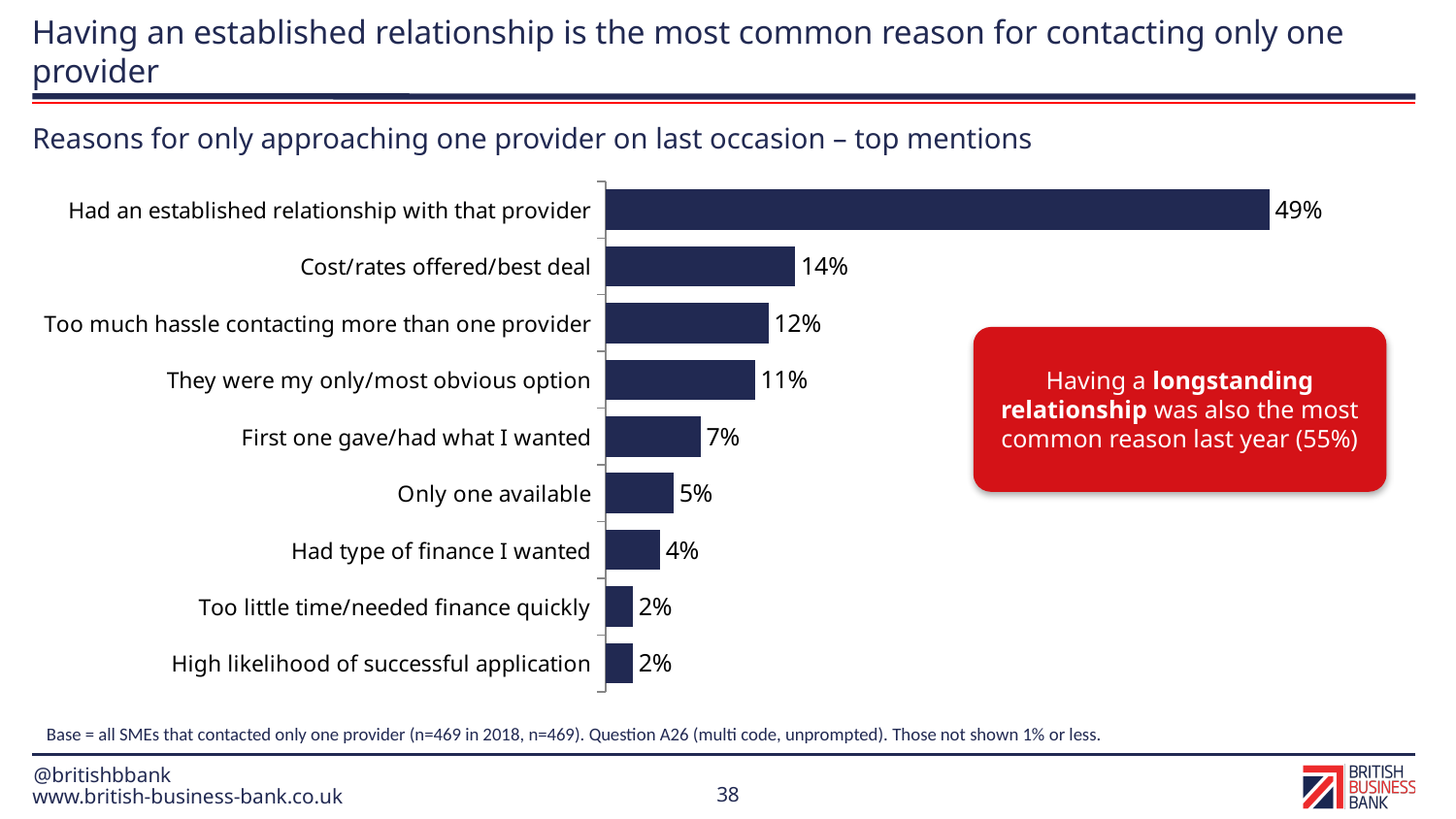
What percentage cited 'Too much hassle contacting more than one provider'? 12% What is the difference between 'They were my only/most obvious option' and 'First one gave/had what I wanted'? 4% Which is larger: 'Too much hassle contacting more than one provider' or 'They were my only/most obvious option'? Too much hassle contacting more than one provider What is the difference between 'Had an established relationship with that provider' and 'Cost/rates offered/best deal'? 35% Which reason has the highest value? Had an established relationship with that provider Which two reasons share the lowest value of 2%? Too little time/needed finance quickly; High likelihood of successful application What is the title of the chart? Reasons for only approaching one provider on last occasion – top mentions What is the value for 'Only one available'? 5% What percentage of SMEs said they had an established relationship with that provider? 49% What kind of chart is shown on the slide? Bar chart How many reasons are shown in the chart? 9 What is the value for 'Cost/rates offered/best deal'? 14%